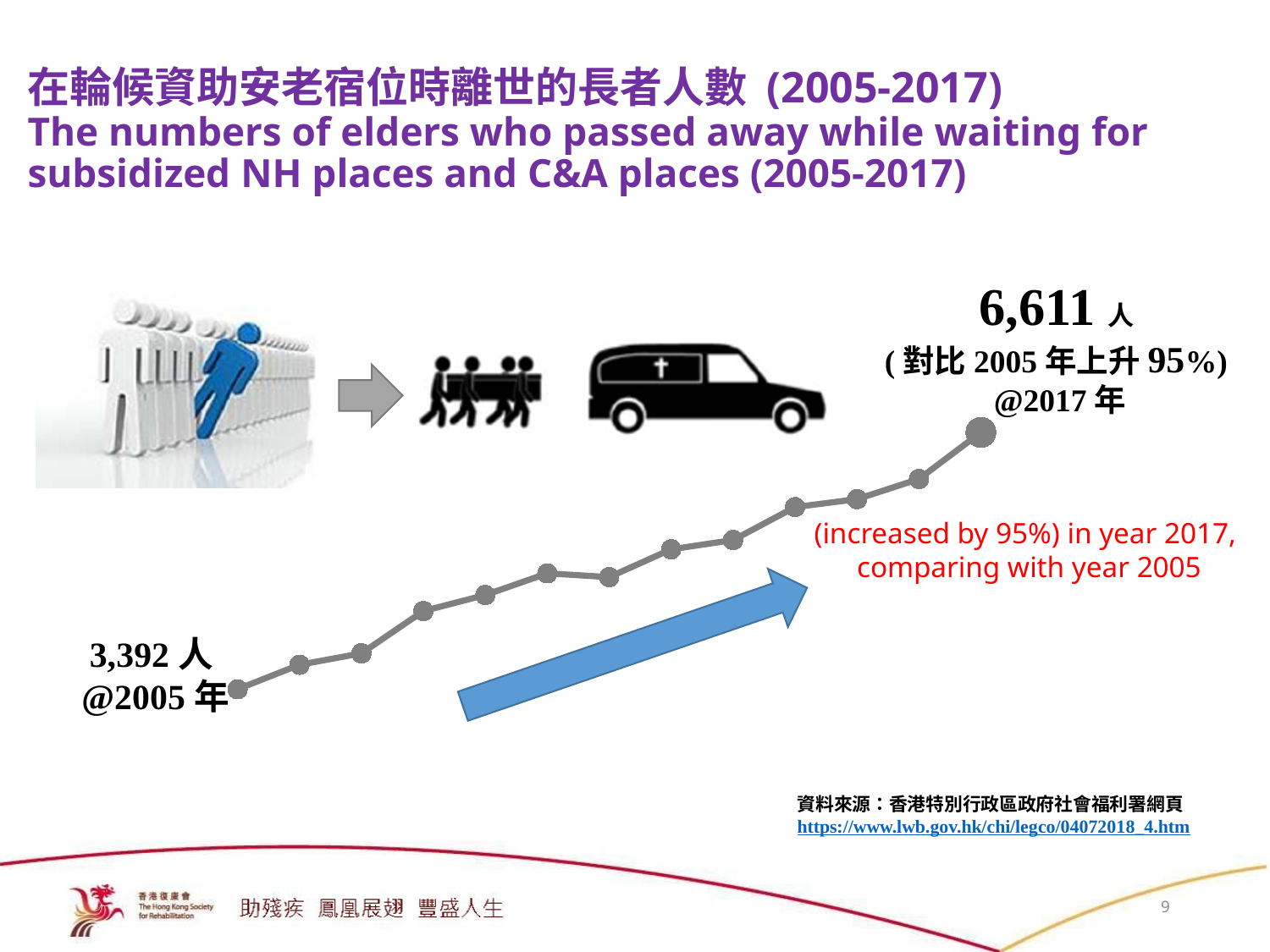
What is the difference between the 2017 value and the 2005 value? 3,219 Which year has the highest value on the chart? 2017 What is the number of elders who passed away while waiting in 2005? 3,392 Which year has the lowest value on the chart? 2005 Which year has the larger value, 2005 or 2017? 2017 What period does the chart cover, according to the title? 2005-2017 How many data points are plotted on the line? 13 By what percentage did the 2017 value increase compared with 2005, according to the slide? 95% What is the number of elders who passed away while waiting in 2017? 6,611 Do the values generally rise or fall from 2005 to 2017? rise What kind of chart is shown on the slide? line chart